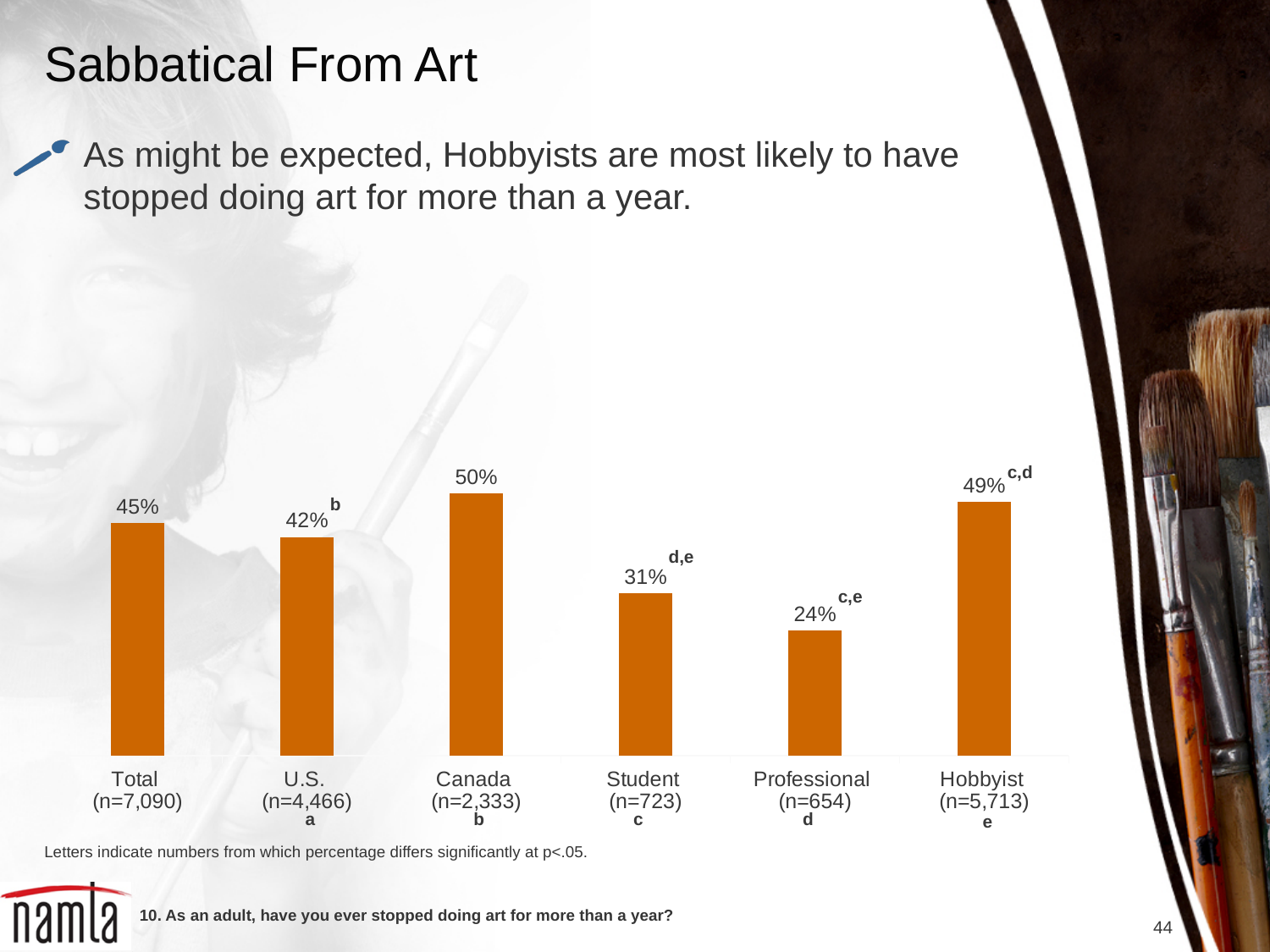
What is the sample size (n) shown for Canada? 2,333 What percentage is shown for Student (n=723)? 31% What percentage is shown for Total (n=7,090)? 45% Which category has the highest percentage? Canada Which category has the lowest percentage? Professional What is the difference in percentage points between Hobbyist and Professional? 25 What is the difference in percentage points between Canada and U.S.? 8 Which has a higher percentage, Student or Hobbyist? Hobbyist How many categories are shown in the chart? 6 What type of chart is shown on the slide? Bar chart What percentage is shown for Hobbyist (n=5,713)? 49% What percentage is shown for Professional (n=654)? 24%